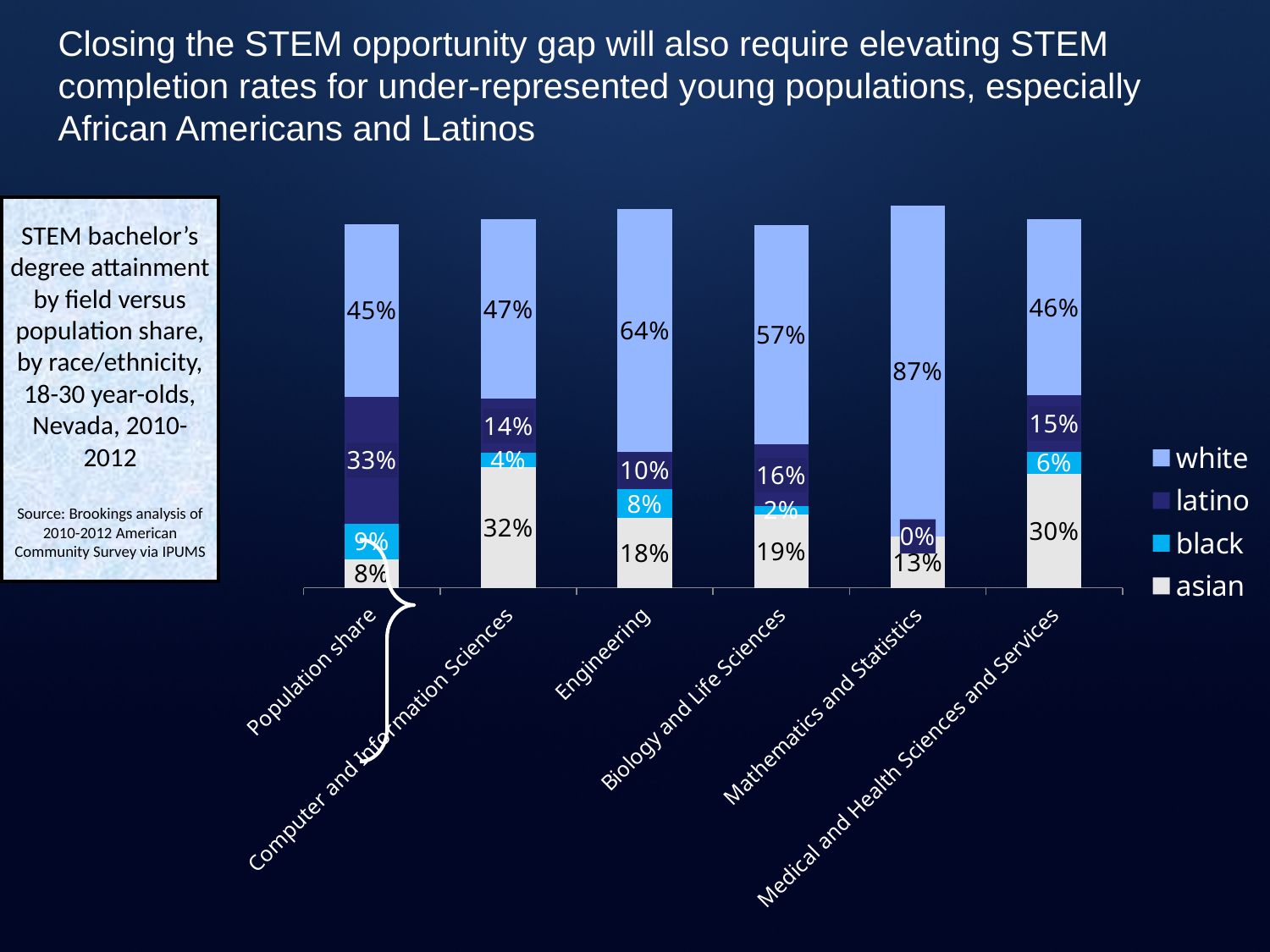
Which series is shown in the lightest blue at the top of each bar, according to the legend? white Which category has the lowest asian share? Population share Which is larger, the latino share for Biology and Life Sciences or the latino share for Engineering? Biology and Life Sciences What is the white share for Engineering? 64% What is the latino share for Population share? 33% What is the black share for Medical and Health Sciences and Services? 6% What is the asian share for Computer and Information Sciences? 32% What is the difference between the white share for Mathematics and Statistics and the white share for Population share? 42% Which category has the highest white share? Mathematics and Statistics How many series does the legend list? 4 How many categories are shown along the x axis? 6 What kind of chart is shown on the slide? stacked bar chart